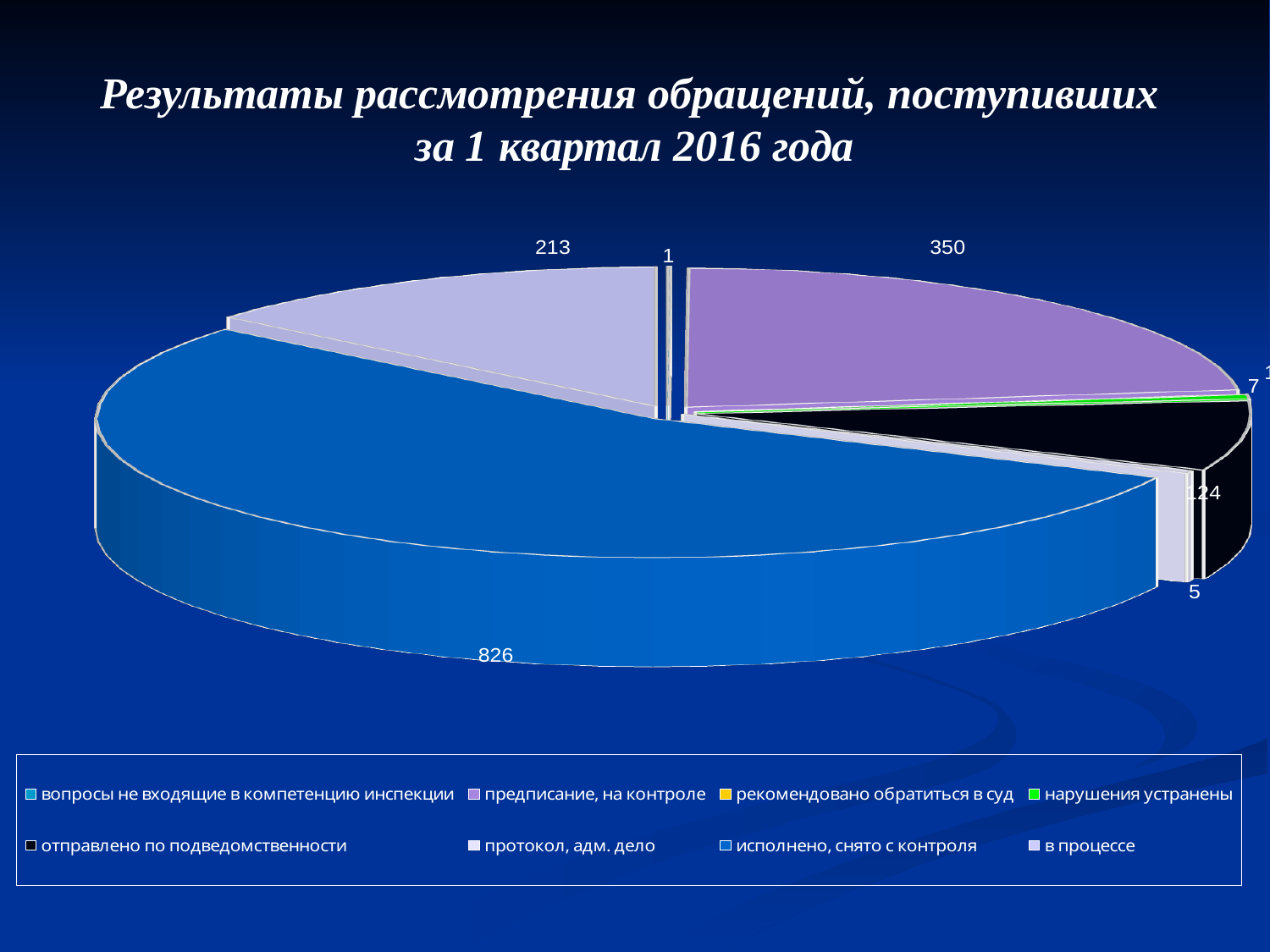
Which category has the largest slice of the pie? исполнено, снято с контроля What is the title of the chart? Результаты рассмотрения обращений, поступивших за 1 квартал 2016 года How many entries does the legend list? 8 What is the value for "отправлено по подведомственности"? 124 What is the value for "в процессе"? 213 Which is larger, "предписание, на контроле" or "в процессе"? предписание, на контроле What is the value for "предписание, на контроле"? 350 What kind of chart is shown on the slide? pie chart What is the value for "исполнено, снято с контроля"? 826 What is the difference between "предписание, на контроле" and "в процессе"? 137 What is the difference between "исполнено, снято с контроля" and "предписание, на контроле"? 476 What colour is the slice for "исполнено, снято с контроля"? blue